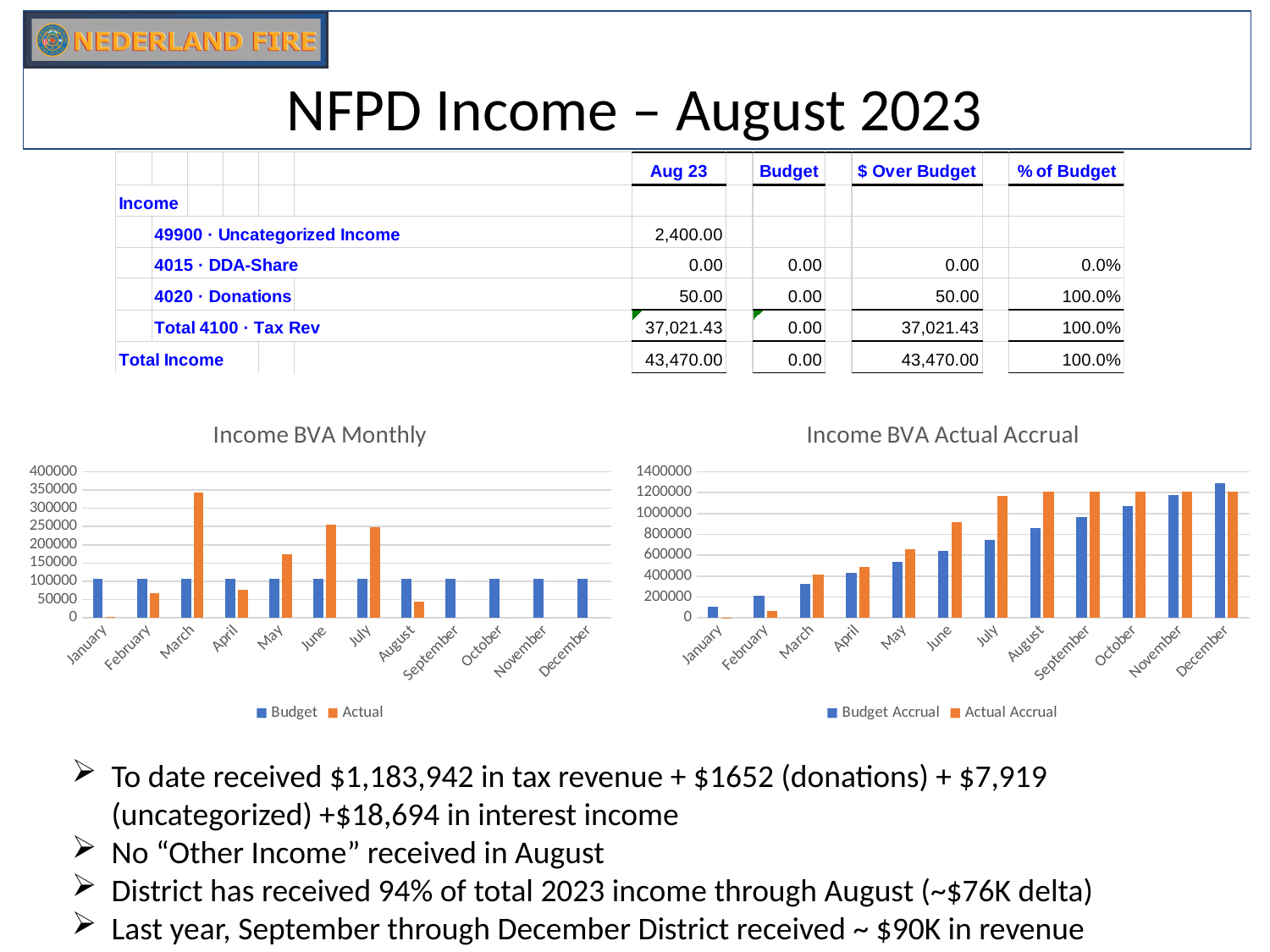
What are the two legend entries of the Income BVA Monthly chart? Budget and Actual How many series does the legend of the Income BVA Actual Accrual chart list? 2 What kind of chart is the Income BVA Monthly chart? bar chart In the Income BVA Monthly chart, which is larger for June, Budget or Actual? Actual In the Income BVA Monthly chart, is the Actual value for March greater or less than 300000? greater What is the title of the chart on the right side of the slide? Income BVA Actual Accrual In the Income BVA Actual Accrual chart, does the Budget Accrual series rise or fall from January to December? rise In the Income BVA Actual Accrual chart, which is larger for April, Budget Accrual or Actual Accrual? Actual Accrual How many months are shown on the x axis of the Income BVA Monthly chart? 12 In the Income BVA Actual Accrual chart, is the Actual Accrual value for July greater or less than 1000000? greater In the Income BVA Monthly chart, which month has the highest Actual value? March